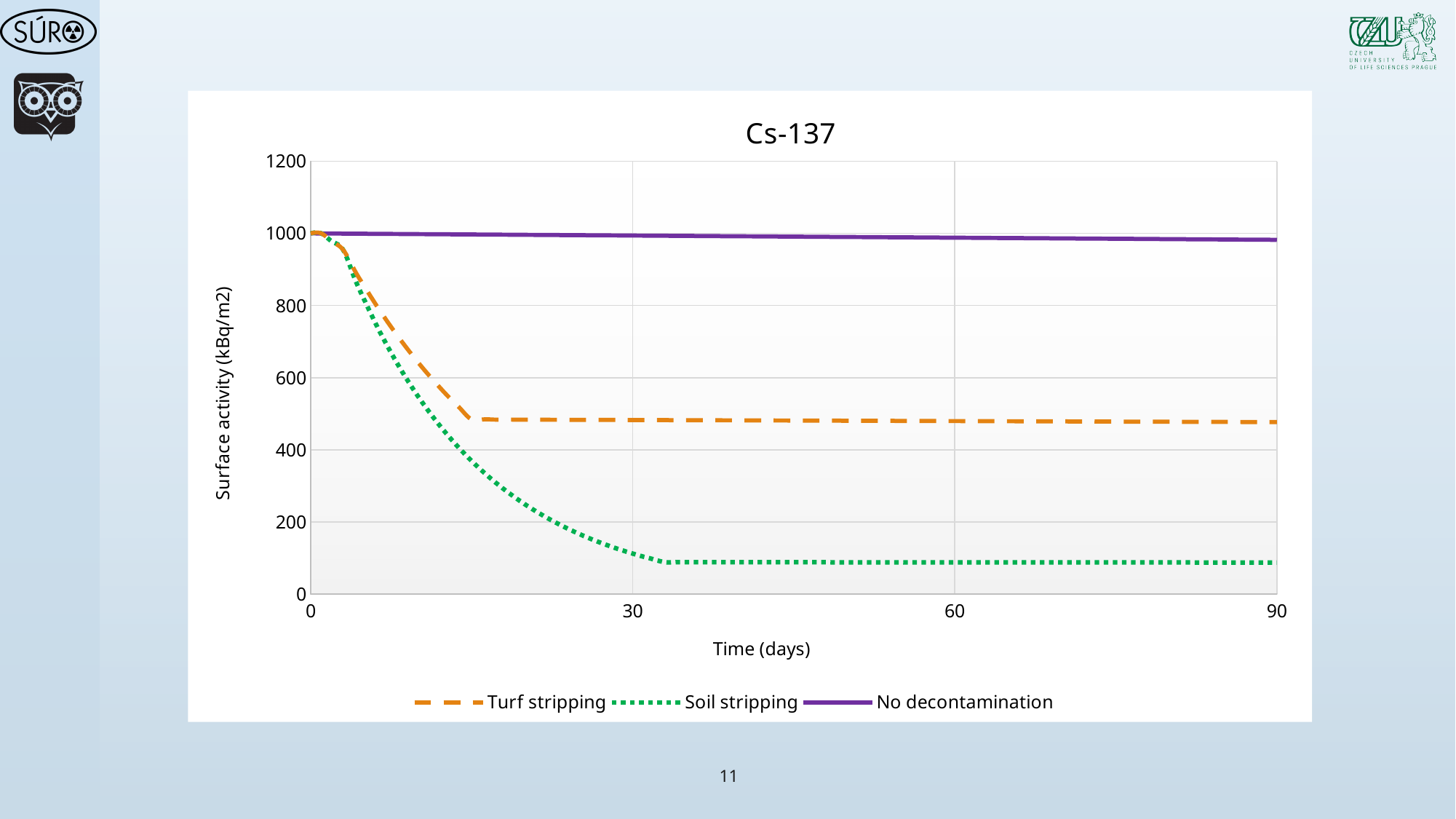
Is the surface activity for No decontamination at 90 days greater or less than 800? greater Which series has the lowest surface activity at 90 days? Soil stripping What kind of chart is shown on the slide? line chart At 60 days, which series has the larger surface activity, Turf stripping or Soil stripping? Turf stripping Is the surface activity for Turf stripping at 90 days greater or less than 600? less Is the surface activity for Turf stripping at 30 days greater or less than 400? greater Does the surface activity for Soil stripping rise or fall over the first 30 days? fall Which series has the highest surface activity at 90 days? No decontamination Which series is drawn as a solid purple line? No decontamination What is the title of the chart? Cs-137 How many series does the legend list? 3